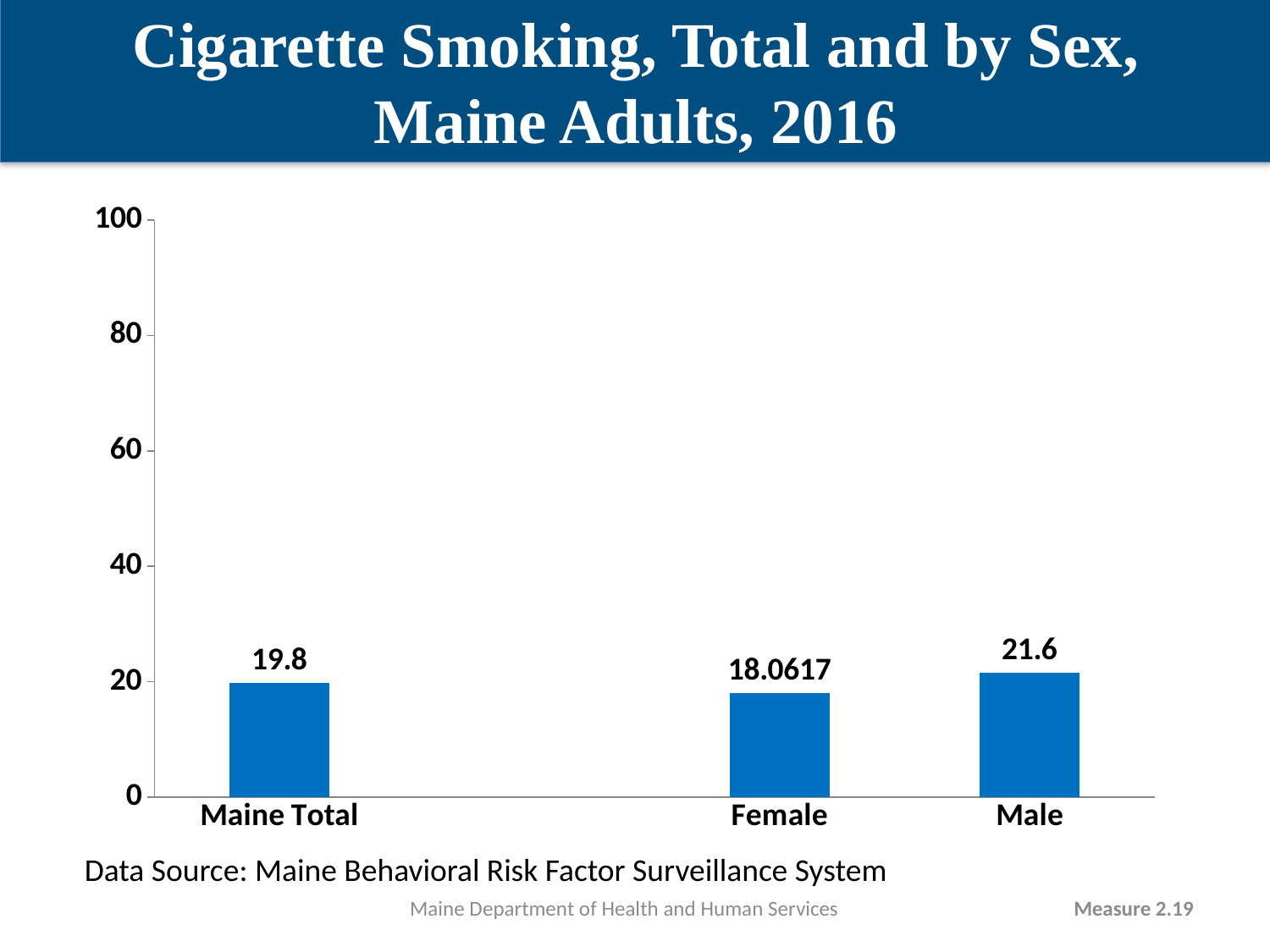
Which category has the lowest value? Female Which category has the highest value? Male What is the value for Male? 21.6 How many categories are shown on the chart? 3 Is the value for Female greater or less than 20? less Which is larger, the value for Male or the value for Female? Male What is the value for Maine Total? 19.8 What is the title of the chart? Cigarette Smoking, Total and by Sex, Maine Adults, 2016 What is the difference between the Male and Maine Total values? 1.8 What kind of chart is shown on the slide? bar chart What is the value for Female? 18.0617 Is the value for Male greater or less than 20? greater